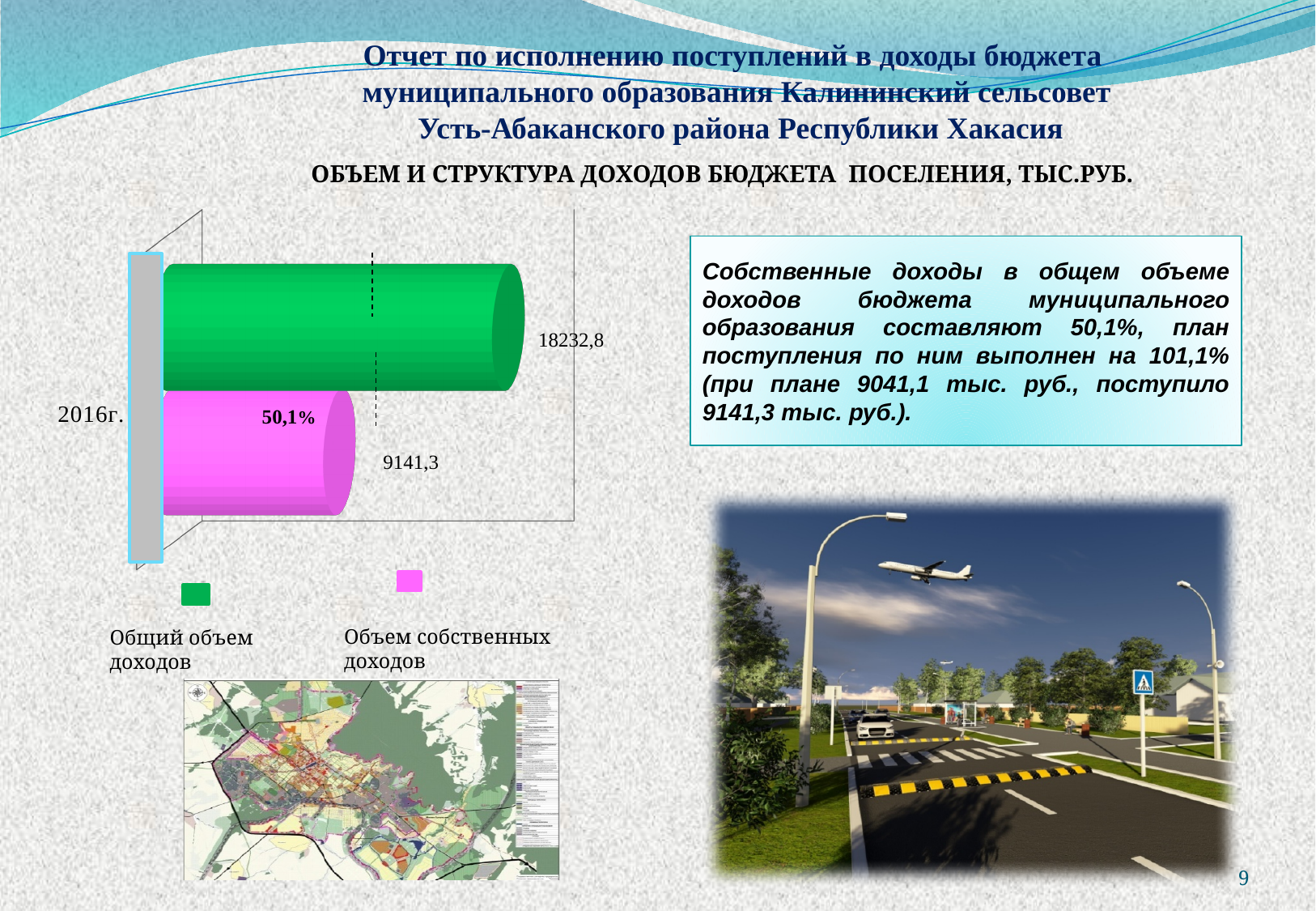
What kind of chart is shown on the slide? bar chart What percentage is printed on the pink bar (Объем собственных доходов)? 50,1% How many categories (years) are shown on the chart? 1 Which series has the larger value for 2016г., Общий объем доходов or Объем собственных доходов? Общий объем доходов Which year is shown as the category on the chart? 2016г. What is the value of the pink bar (Объем собственных доходов) for 2016г.? 9141,3 How many series does the legend list? 2 What is the difference between Общий объем доходов and Объем собственных доходов for 2016г.? 9091,5 What is the title of the chart? ОБЪЕМ И СТРУКТУРА ДОХОДОВ БЮДЖЕТА ПОСЕЛЕНИЯ, ТЫС.РУБ. Which series has the smallest value on the chart? Объем собственных доходов What is the value of the green bar (Общий объем доходов) for 2016г.? 18232,8 What colour represents Объем собственных доходов in the legend? pink